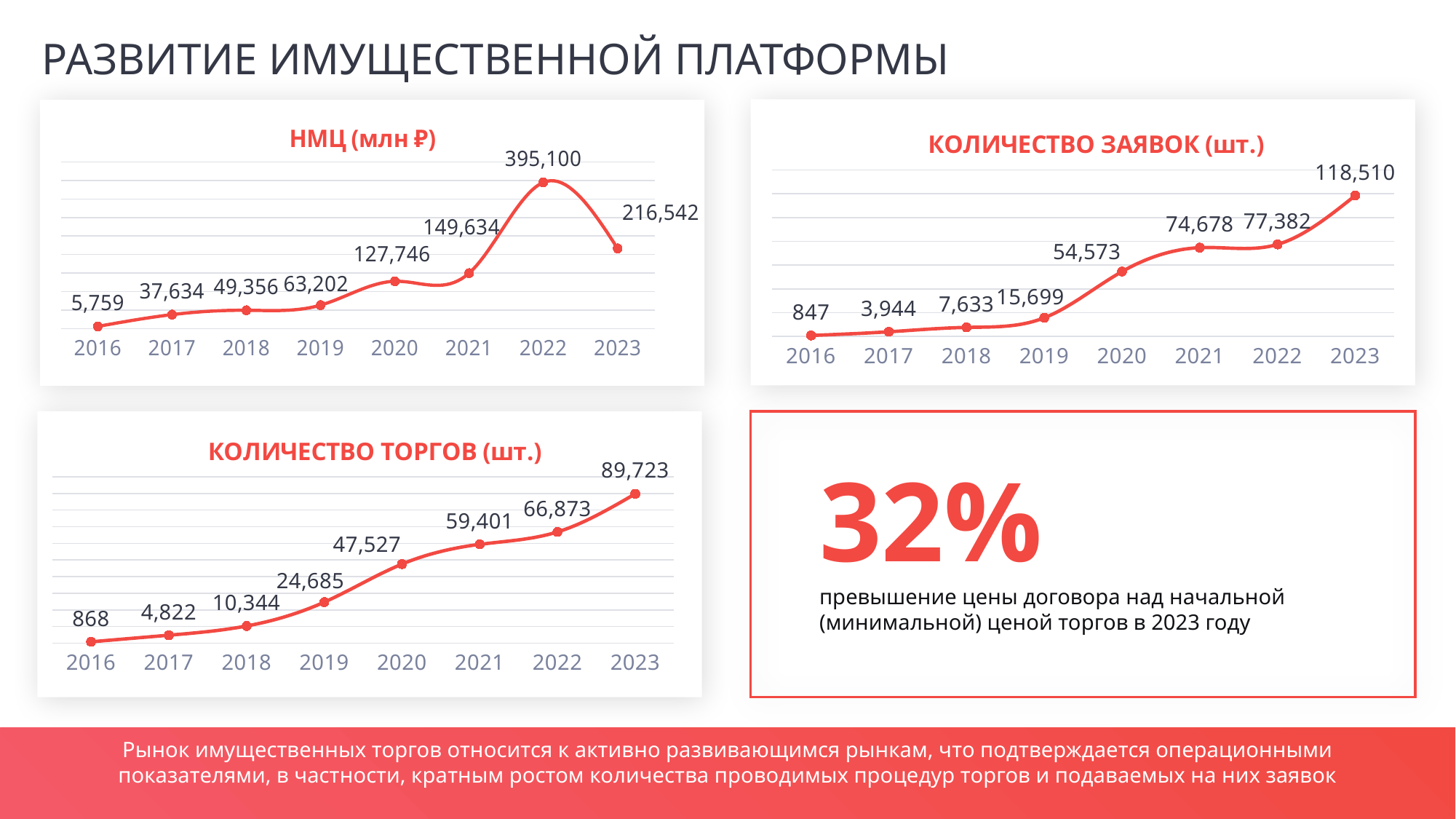
In the chart titled 'КОЛИЧЕСТВО ЗАЯВОК (шт.)', what is the difference between the 2023 and 2022 values? 41,128 What kind of chart is the chart titled 'КОЛИЧЕСТВО ТОРГОВ (шт.)'? line chart In the chart titled 'КОЛИЧЕСТВО ЗАЯВОК (шт.)', do the values rise or fall from 2016 to 2023? rise In the chart titled 'НМЦ (млн ₽)', what is the difference between the 2022 and 2023 values? 178,558 In the chart titled 'НМЦ (млн ₽)', which year has the highest value? 2022 In the chart titled 'КОЛИЧЕСТВО ТОРГОВ (шт.)', what is the value for 2023? 89,723 In the chart titled 'КОЛИЧЕСТВО ЗАЯВОК (шт.)', what is the value for 2020? 54,573 In the chart titled 'КОЛИЧЕСТВО ТОРГОВ (шт.)', which is larger, the value for 2020 or the value for 2021? 2021 In the chart titled 'КОЛИЧЕСТВО ТОРГОВ (шт.)', what is the value for 2019? 24,685 In the chart titled 'КОЛИЧЕСТВО ЗАЯВОК (шт.)', which year has the lowest value? 2016 In the chart titled 'НМЦ (млн ₽)', how many data points are plotted? 8 In the chart titled 'НМЦ (млн ₽)', what is the value for 2022? 395,100